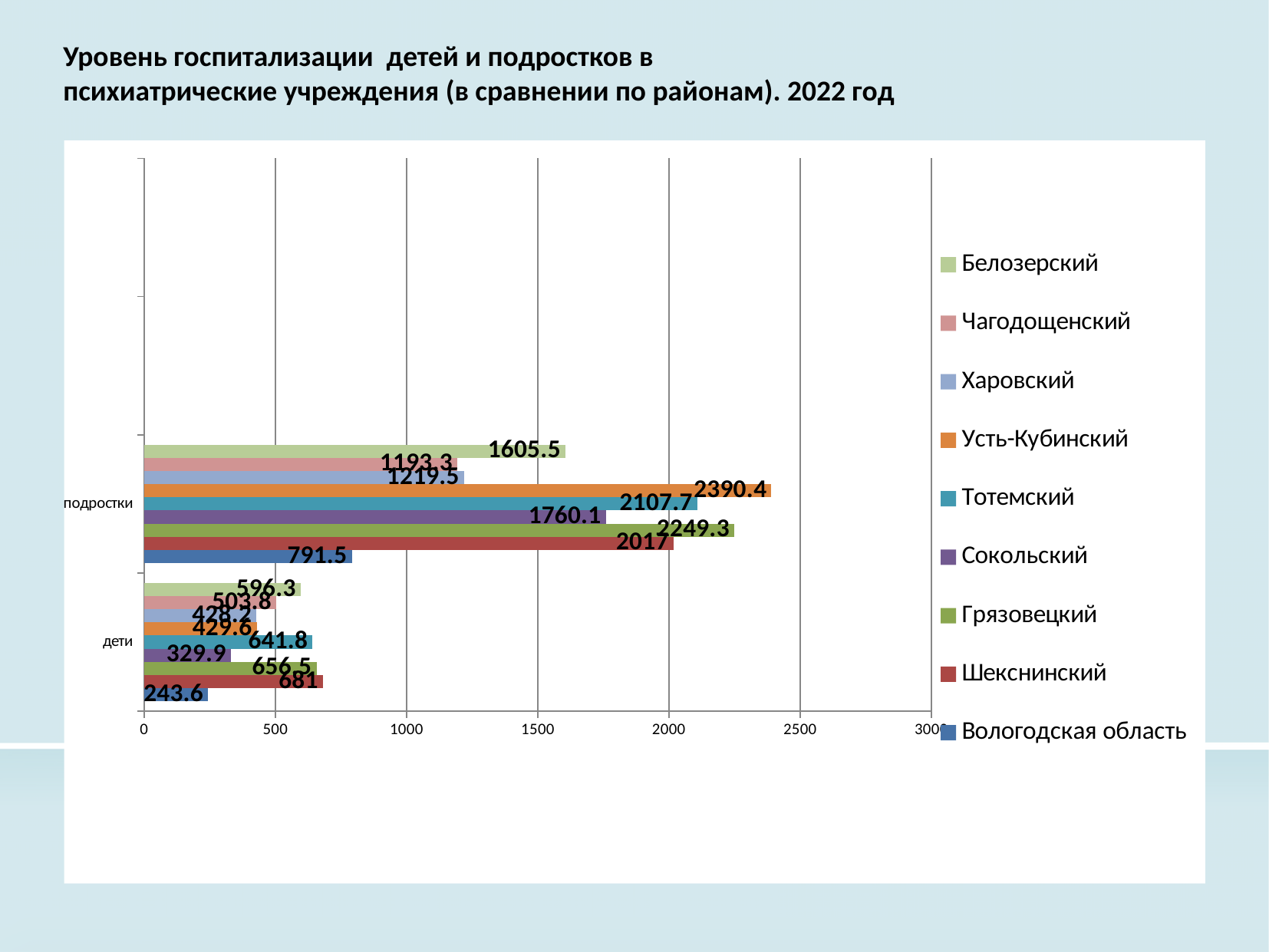
Which series has the highest value in the подростки category? Усть-Кубинский How many series does the legend list? 9 In the подростки category, which is larger: Грязовецкий or Шекснинский? Грязовецкий Which series has the highest value in the дети category? Шекснинский Which series has the lowest value in the подростки category? Вологодская область What is the value for Вологодская область in the дети category? 243.6 How many categories are shown on the vertical axis? 2 What is the value for Усть-Кубинский in the подростки category? 2390.4 What is the value for Сокольский in the дети category? 329.9 What is the difference between the подростки values for Усть-Кубинский and Тотемский? 282.7 Is the value for Белозерский in the подростки category greater or less than 1500? greater What kind of chart is shown on the slide? bar chart